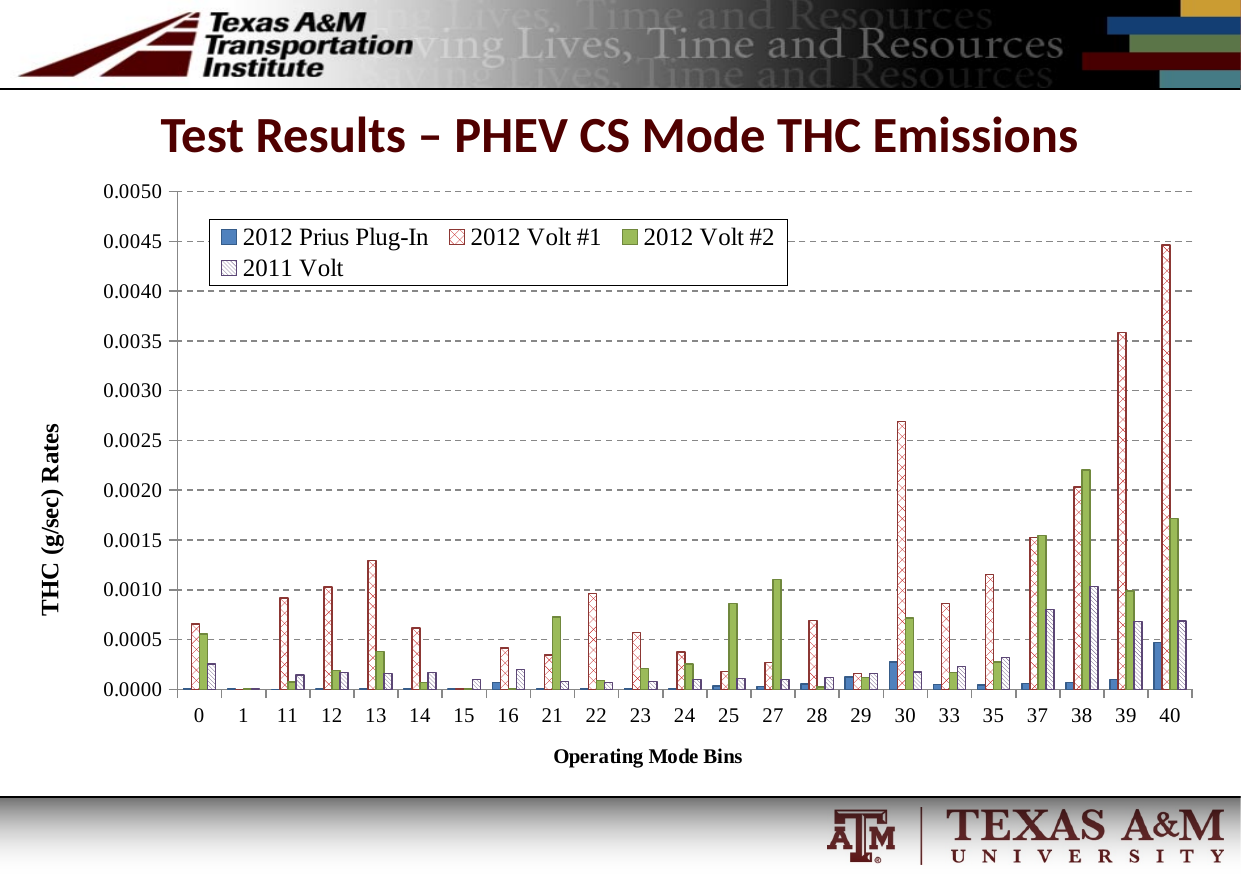
At which operating mode bin does the 2012 Volt #1 series reach its highest value? 40 Is the value for 2012 Volt #2 at bin 27 greater or less than 0.0015? less What kind of chart is shown on the slide? bar chart Is the value for 2012 Volt #1 at bin 30 greater or less than 0.0025? greater What is the label of the y axis? THC (g/sec) Rates How many series does the legend list? 4 Is the value for 2012 Volt #1 at bin 40 greater or less than 0.0040? greater How many operating mode bins are shown on the x axis? 23 At which operating mode bin does the 2011 Volt series reach its highest value? 38 At bin 25, which is larger: 2012 Volt #1 or 2012 Volt #2? 2012 Volt #2 At bin 40, which is larger: 2012 Volt #1 or 2012 Volt #2? 2012 Volt #1 At which operating mode bin does the 2012 Volt #2 series reach its highest value? 38